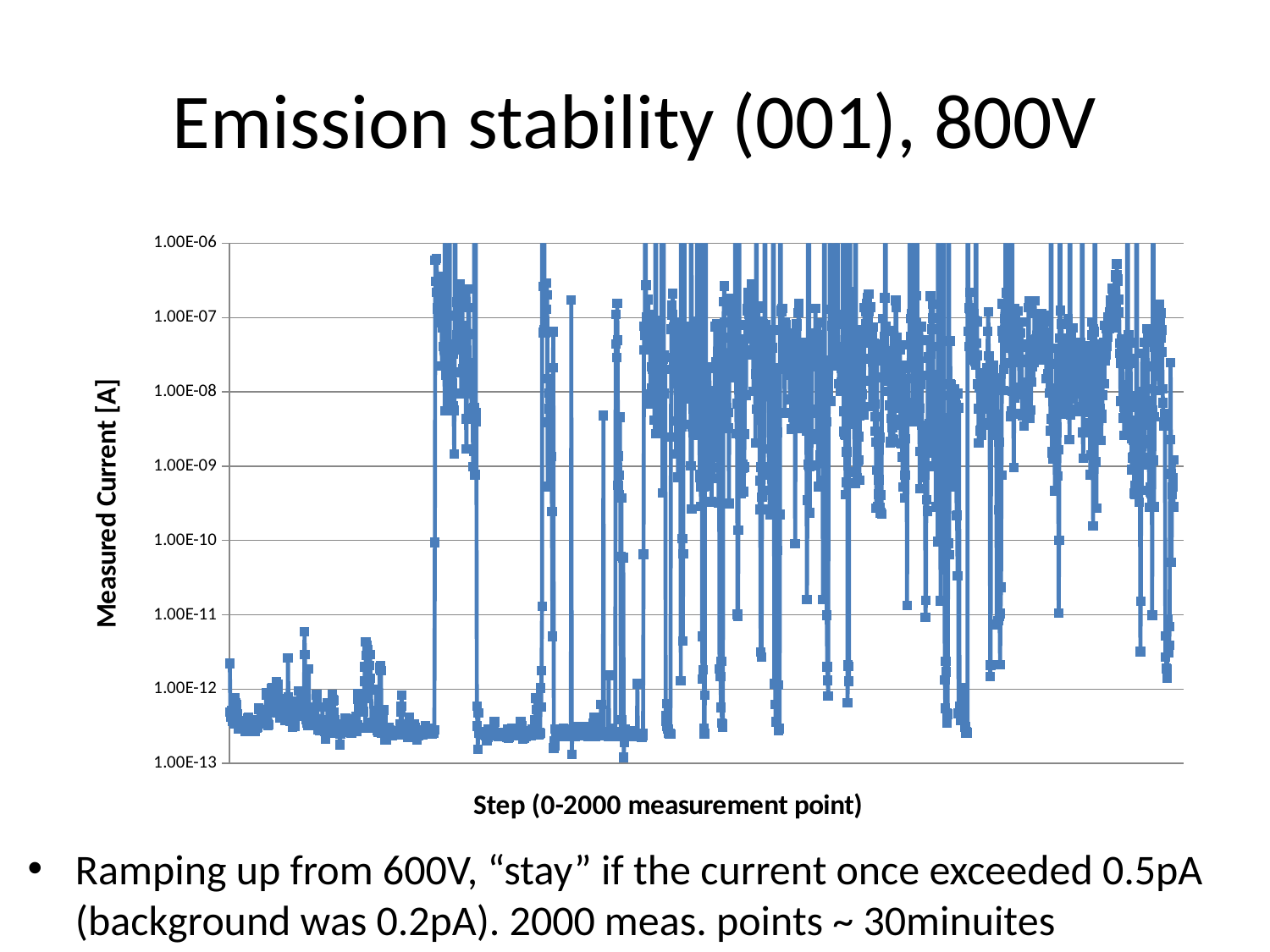
What is the label of the horizontal axis of the chart? Step (0-2000 measurement point) How many data series are plotted in the chart? 1 Are the measured current values at the far left of the x axis greater or less than 1.00E-10? less What is the label of the vertical axis of the chart? Measured Current [A] Overall, do the measured current values rise or fall from the left to the right of the x axis? rise What kind of chart is shown on the slide? line chart Are the measured current values at the far right of the x axis mostly greater or less than 1.00E-10? greater